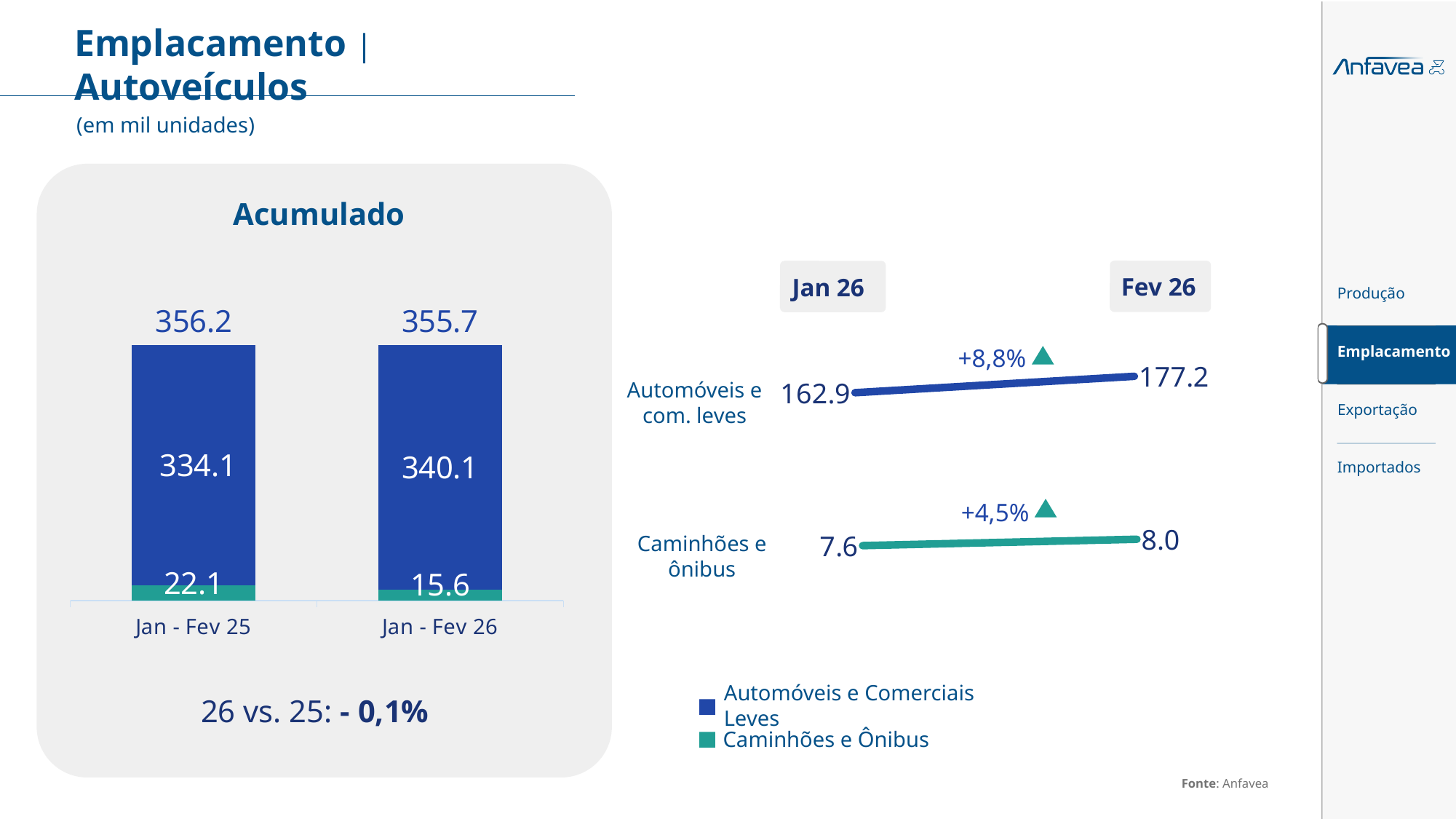
In the Acumulado chart, what is the difference between the Caminhões e Ônibus values for Jan - Fev 25 and Jan - Fev 26? 6.5 In the Acumulado chart, how many periods are shown on the x axis? 2 What kind of chart is the Acumulado chart? Stacked bar chart In the right-hand chart, does the Caminhões e ônibus line rise or fall from Jan 26 to Fev 26? Rises In the right-hand chart, what is the difference between the Automóveis e com. leves values for Fev 26 and Jan 26? 14.3 In the Acumulado chart, what is the value for Automóveis e Comerciais Leves in Jan - Fev 26? 340.1 In the Acumulado chart, what is the value for Caminhões e Ônibus in Jan - Fev 25? 22.1 How many series does the legend list? 2 In the right-hand chart, what is the value for Automóveis e com. leves in Fev 26? 177.2 In the Acumulado chart, what is the total of the stacked bar for Jan - Fev 25? 356.2 In the Acumulado chart, which period has the higher total, Jan - Fev 25 or Jan - Fev 26? Jan - Fev 25 In the right-hand chart, what is the value for Caminhões e ônibus in Jan 26? 7.6